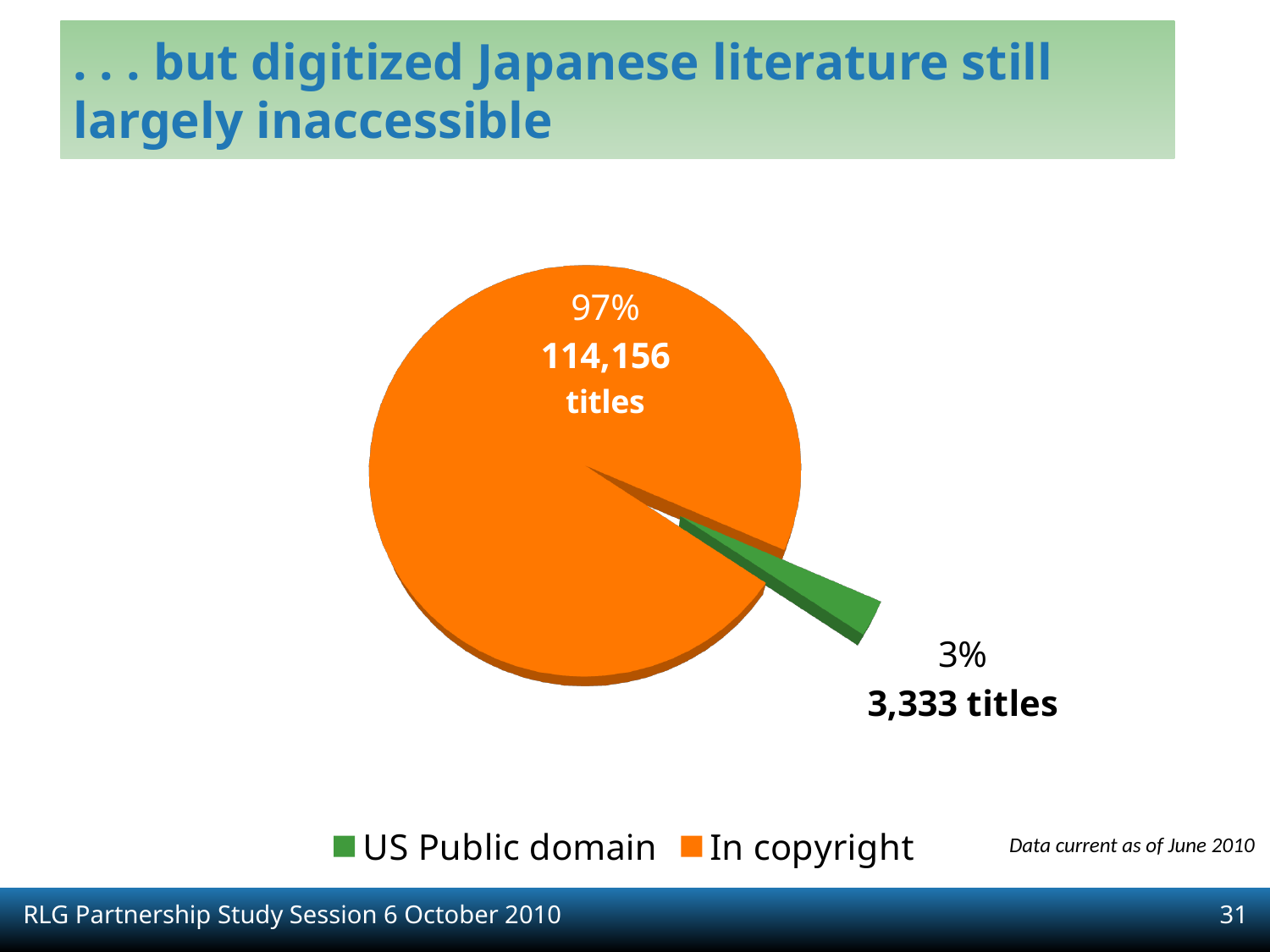
What colour is the US Public domain slice? green What percentage of the pie is US Public domain? 3% Which category has the largest slice of the pie? In copyright How many titles are In copyright? 114,156 titles Which category has the smallest slice of the pie? US Public domain How many categories does the pie chart have? 2 Which is larger, the number of In copyright titles or the number of US Public domain titles? In copyright What is the total number of titles across both slices? 117,489 titles What is the difference in titles between In copyright and US Public domain? 110,823 titles What kind of chart is shown on the slide? pie chart What percentage of the pie is In copyright? 97% How many titles are US Public domain? 3,333 titles